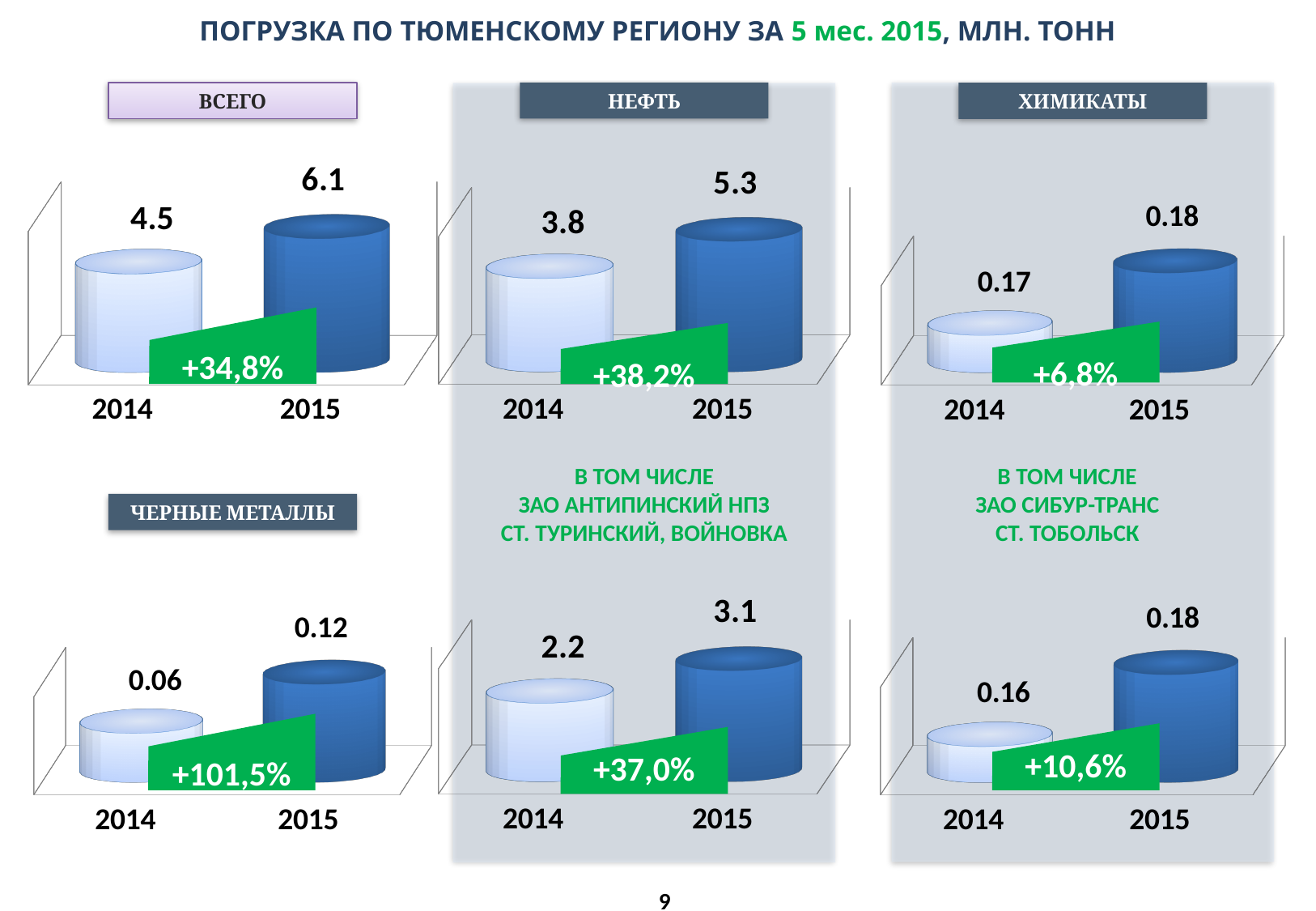
What kind of chart is the "ВСЕГО" chart? bar chart In the "НЕФТЬ" chart, which year has the higher value, 2014 or 2015? 2015 In the chart for ЗАО СИБУР-ТРАНС (bottom right), what is the value for 2014? 0.16 In the chart for ЗАО АНТИПИНСКИЙ НПЗ (bottom middle), do the values rise or fall from 2014 to 2015? rise In the "ВСЕГО" chart, what is the value for 2015? 6.1 In the "ЧЕРНЫЕ МЕТАЛЛЫ" chart, what is the value for 2014? 0.06 In the "НЕФТЬ" chart, what is the value for 2014? 3.8 In the "ЧЕРНЫЕ МЕТАЛЛЫ" chart, what is the difference between the 2015 and 2014 values? 0.06 What percentage change is shown in the "ЧЕРНЫЕ МЕТАЛЛЫ" chart? +101,5% In the "ХИМИКАТЫ" chart, what is the value for 2015? 0.18 How many years are shown in the "ХИМИКАТЫ" chart? 2 In the "ВСЕГО" chart, what is the difference between the 2015 and 2014 values? 1.6